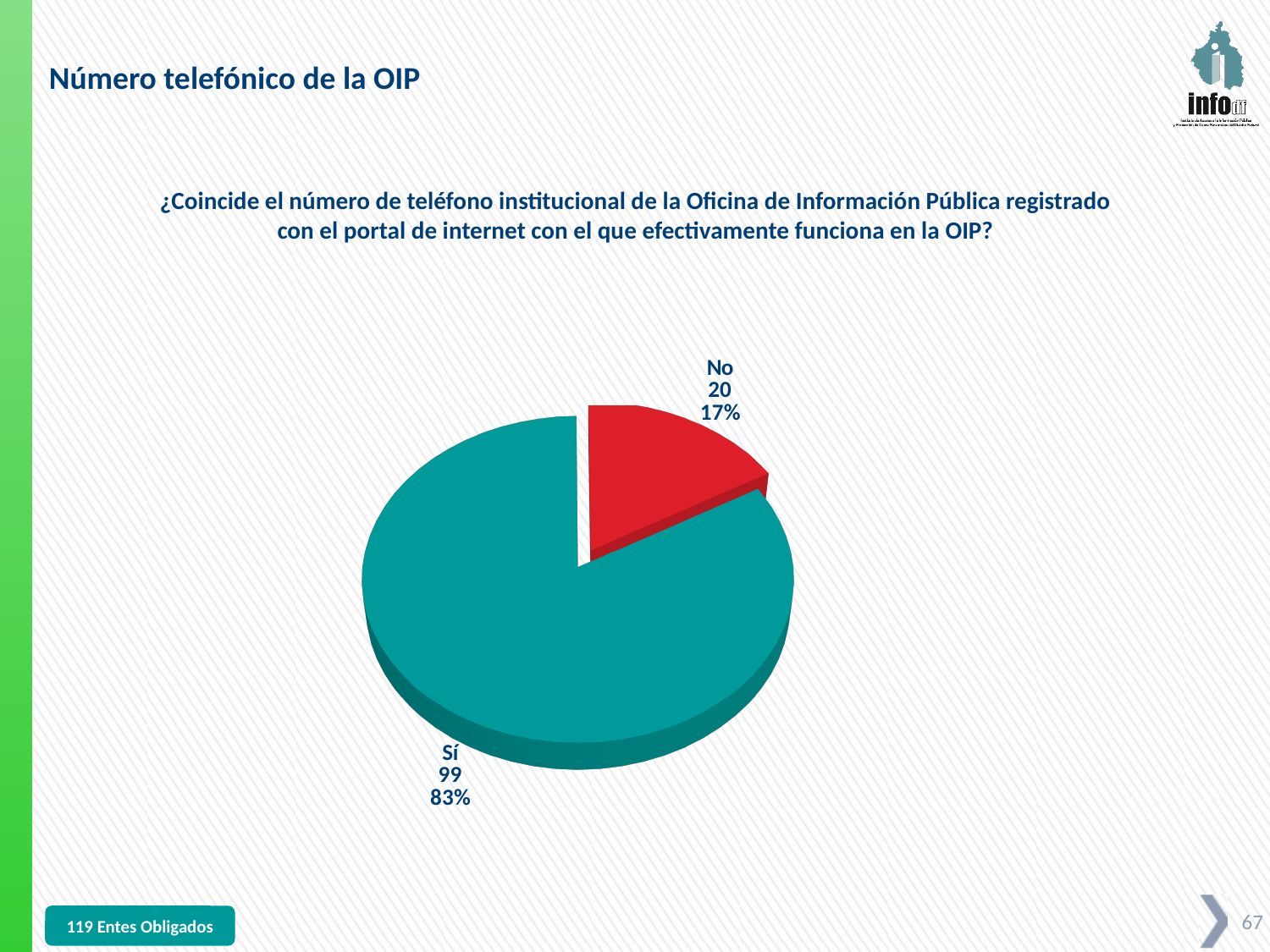
What kind of chart is shown on the slide? Pie chart What is the value for the "No" slice? 20 Which is larger, the value for "Sí" or the value for "No"? Sí What is the difference between the "Sí" and "No" values? 79 What percentage share does the "Sí" slice represent? 83% What colour is the "No" slice? Red What is the value for the "Sí" slice? 99 Which slice is the largest? Sí Which slice is the smallest? No How many slices does the pie chart have? 2 What is the total of the two slices in the pie chart? 119 What percentage share does the "No" slice represent? 17%